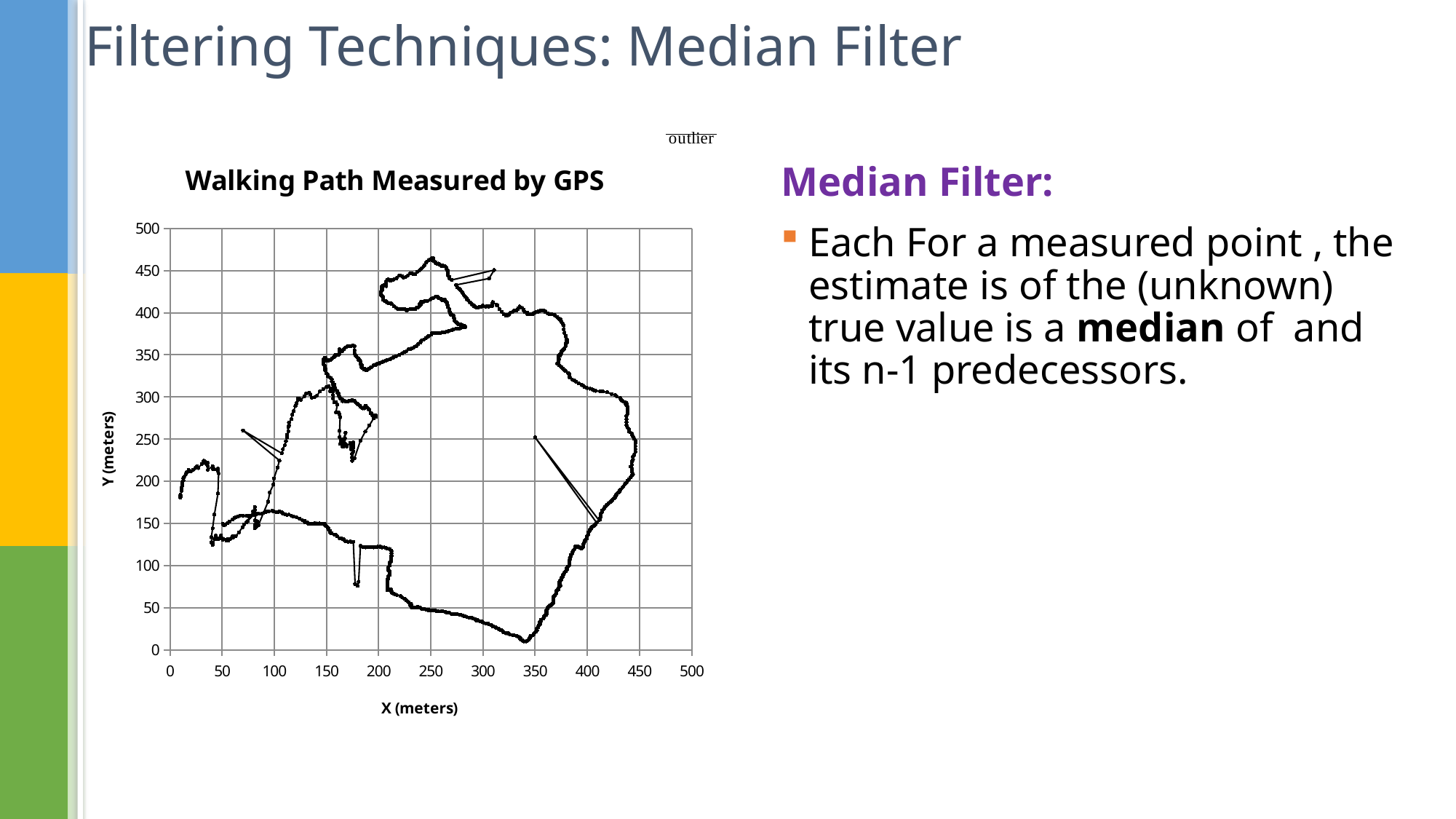
Is the smallest X value reached by the walking path greater or less than 50? less What is the label of the horizontal axis of the chart? X (meters) Is the largest X value reached by the walking path greater or less than 400? greater What kind of chart is shown on the slide? scatter chart What is the title of the chart on the slide? Walking Path Measured by GPS Is the highest Y value reached by the walking path greater or less than 450? greater